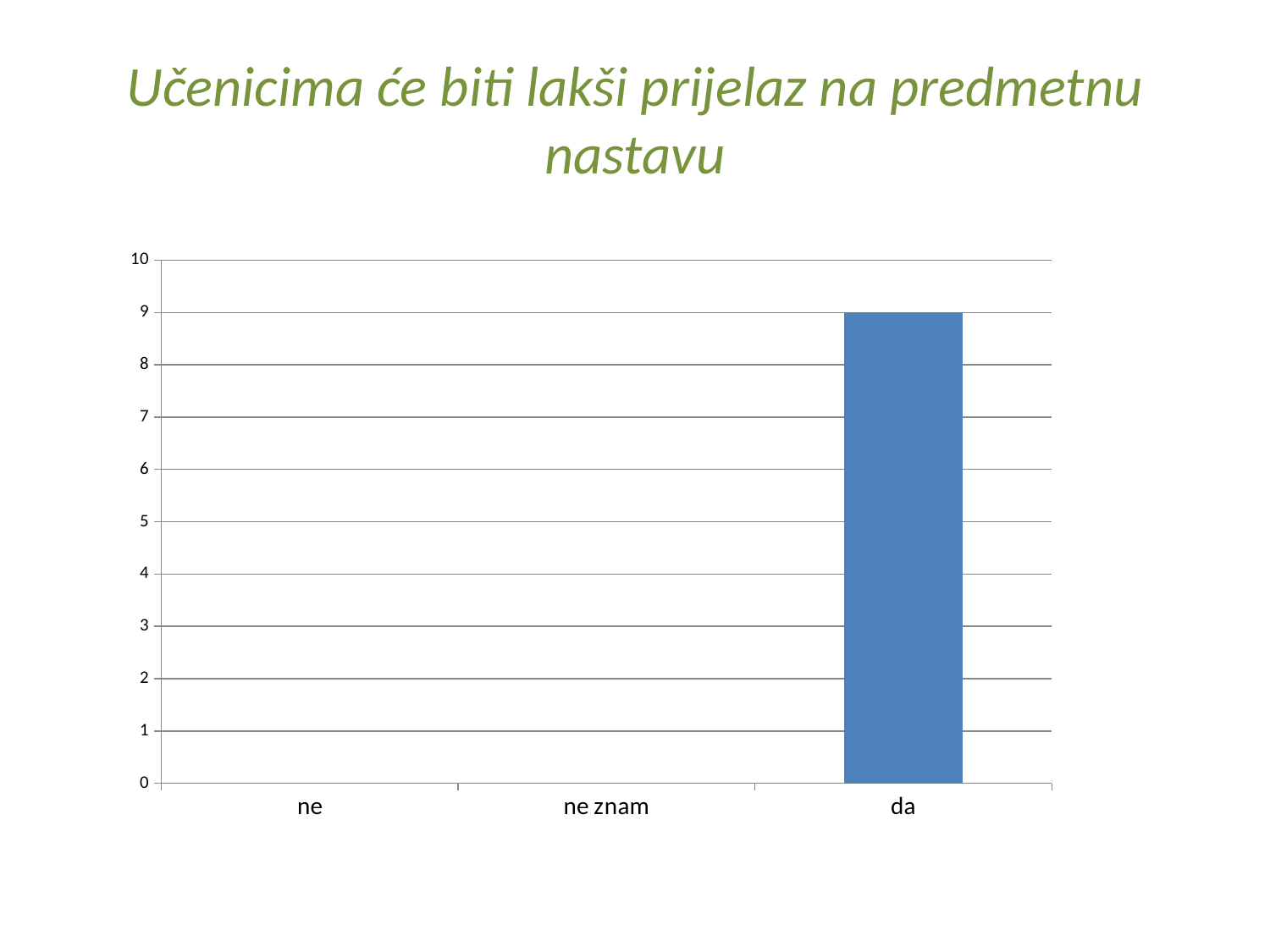
What is the title of the slide? Učenicima će biti lakši prijelaz na predmetnu nastavu What is the value for "ne znam"? 0 What is the value for "ne"? 0 What is the value for "da"? 9 What is the maximum value shown on the y axis? 10 Which category has the highest value? da What is the difference between the values for "da" and "ne"? 9 How many categories are shown on the x axis? 3 Is the value for "da" greater or less than 5? greater Which is larger, the value for "da" or the value for "ne znam"? da What kind of chart is shown on the slide? bar chart